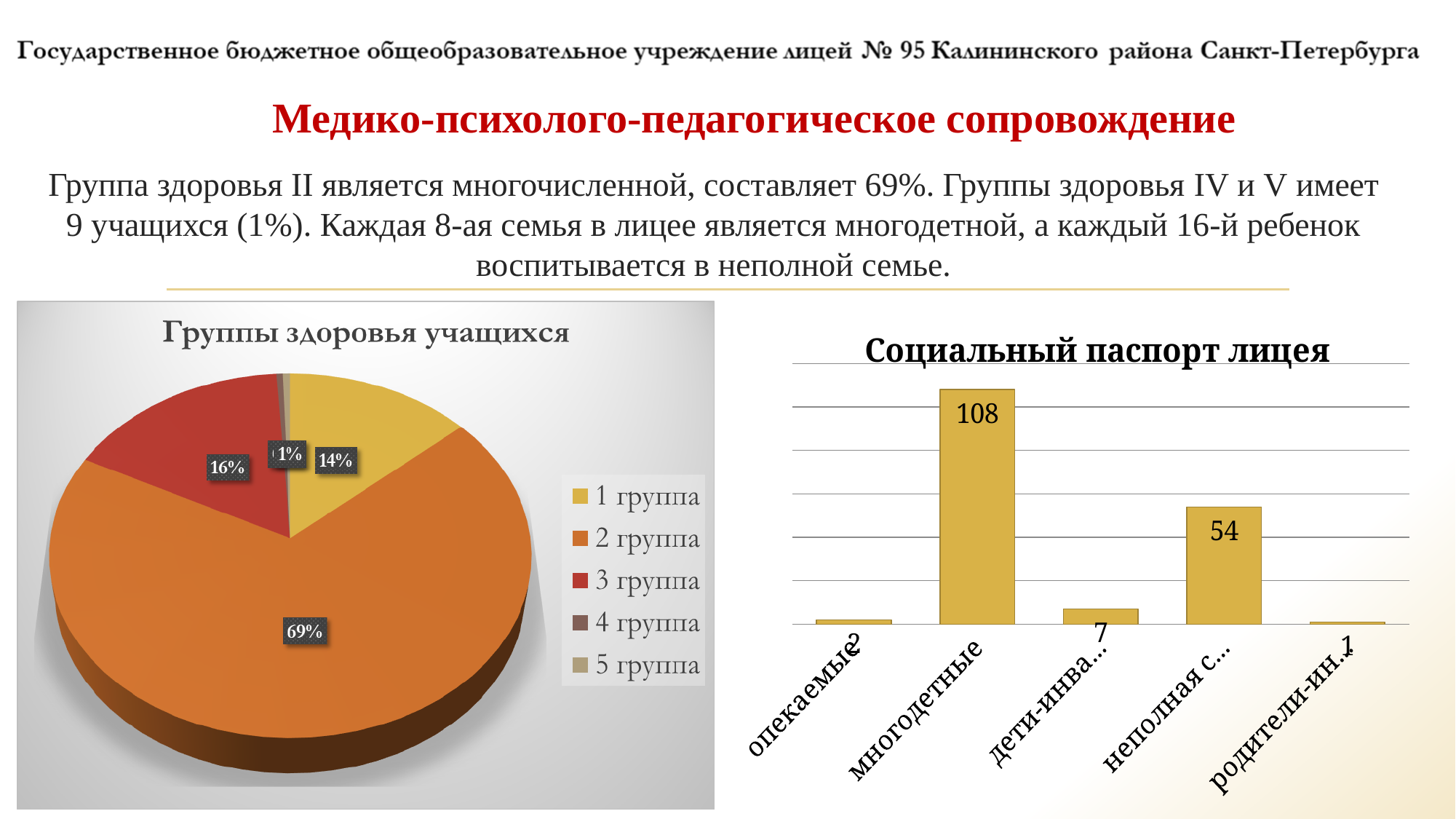
What kind of chart is the 'Группы здоровья учащихся' chart on the left? pie chart In the 'Группы здоровья учащихся' pie chart, what share does '1 группа' have? 14% In the 'Социальный паспорт лицея' chart, what is the difference between the value for 'многодетные' and the value for the category whose label begins 'неполная'? 54 How many categories are shown in the 'Социальный паспорт лицея' bar chart? 5 How many entries does the legend of the 'Группы здоровья учащихся' pie chart list? 5 In the 'Социальный паспорт лицея' chart, which category has the highest value? многодетные In the 'Группы здоровья учащихся' pie chart, which slice is larger: '1 группа' or '3 группа'? 3 группа In the 'Группы здоровья учащихся' pie chart, what share does '2 группа' have? 69% In the 'Социальный паспорт лицея' chart, what is the value for 'многодетные'? 108 In the 'Группы здоровья учащихся' pie chart, what share does '3 группа' have? 16% In the 'Группы здоровья учащихся' pie chart, which group has the largest slice? 2 группа What kind of chart is the 'Социальный паспорт лицея' chart on the right? bar chart